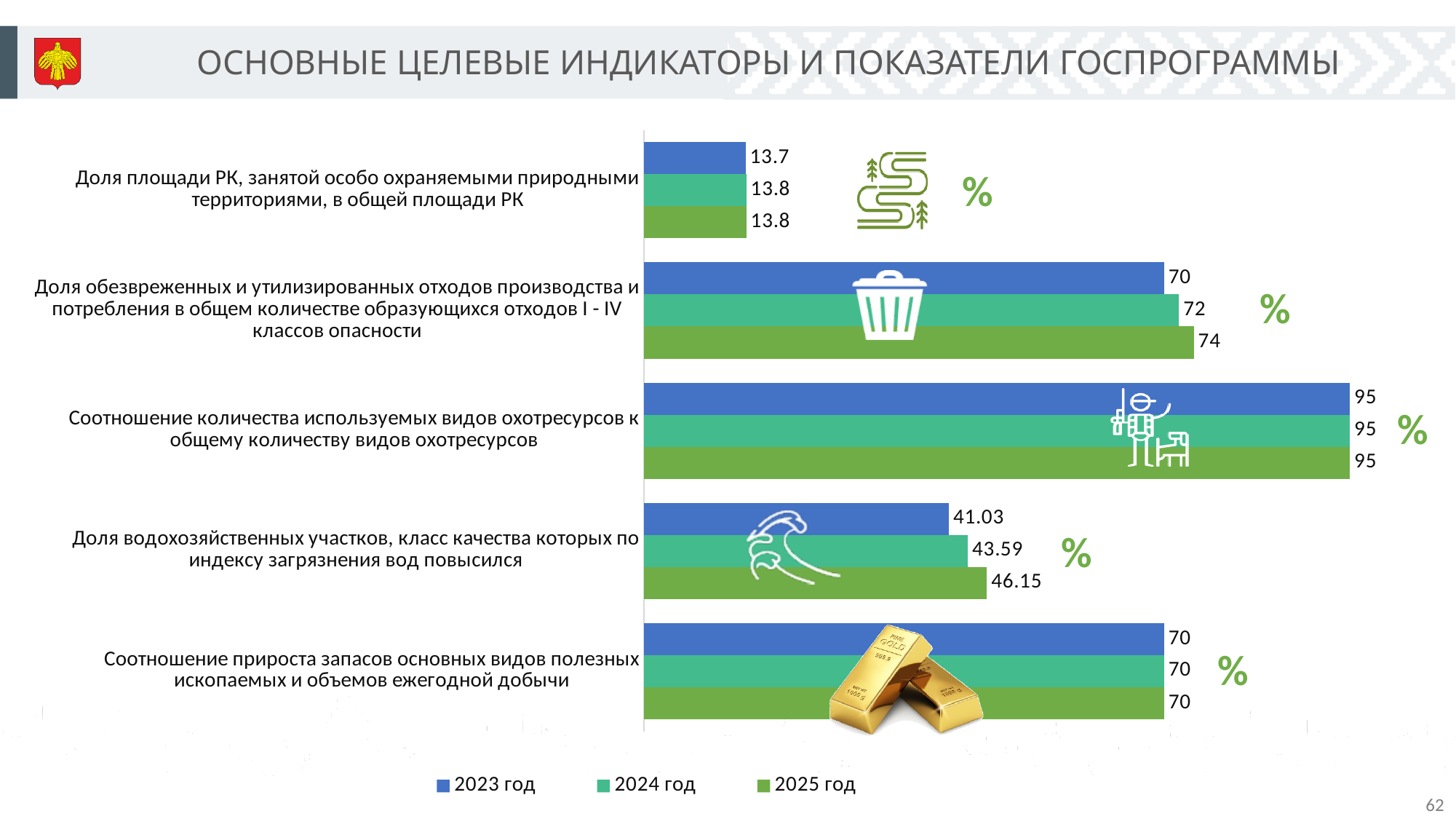
Which is larger for "Доля обезвреженных и утилизированных отходов...": the 2023 год value or the 2024 год value? 2024 год What is the 2025 год value for "Доля обезвреженных и утилизированных отходов производства и потребления в общем количестве образующихся отходов I - IV классов опасности"? 74 Which category has the lowest values across all three years? Доля площади РК, занятой особо охраняемыми природными территориями, в общей площади РК What is the 2023 год value for "Доля площади РК, занятой особо охраняемыми природными территориями, в общей площади РК"? 13.7 Which legend entry is shown in blue? 2023 год What type of chart is shown on the slide? bar chart How many categories (indicators) are plotted in the chart? 5 How many series does the legend list? 3 What is the difference between the 2025 год and 2023 год values for "Доля водохозяйственных участков, класс качества которых по индексу загрязнения вод повысился"? 5.12 What is the 2024 год value for "Доля водохозяйственных участков, класс качества которых по индексу загрязнения вод повысился"? 43.59 Which category has the highest values across all three years? Соотношение количества используемых видов охотресурсов к общему количеству видов охотресурсов Do the values for "Доля обезвреженных и утилизированных отходов..." rise or fall from 2023 год to 2025 год? rise